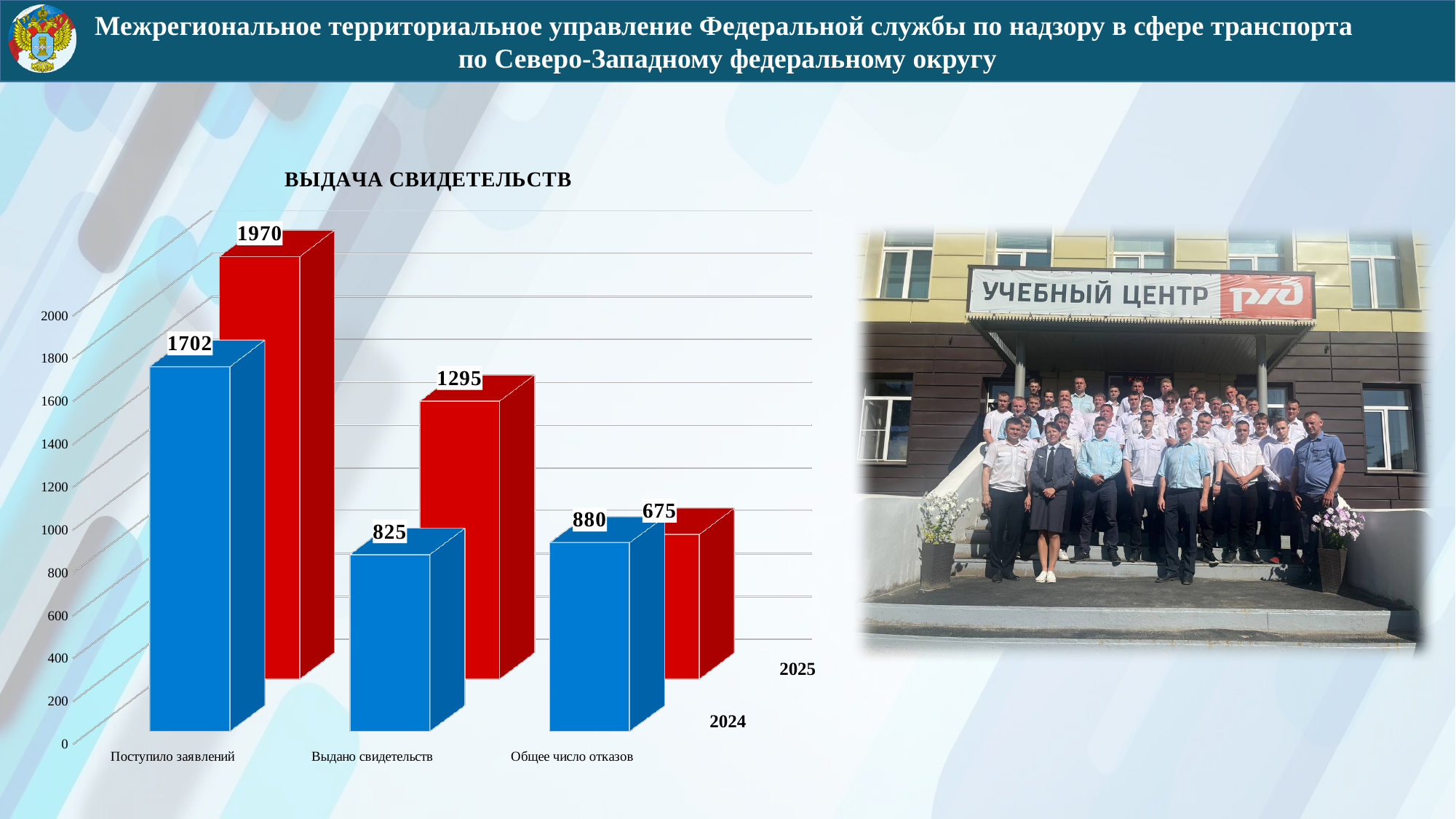
What is the value for Общее число отказов in 2024? 880 What is the title of the chart? ВЫДАЧА СВИДЕТЕЛЬСТВ Which category has the highest value in the 2025 series? Поступило заявлений What type of chart is shown on the slide? bar chart What is the value for Поступило заявлений in 2025? 1970 Which category has the lowest value in the 2024 series? Выдано свидетельств What is the value for Поступило заявлений in 2024? 1702 Which is larger for Общее число отказов: the 2024 value or the 2025 value? 2024 What is the difference between the 2025 and 2024 values for Выдано свидетельств? 470 What is the value for Выдано свидетельств in 2025? 1295 How many series does the chart show? 2 How many categories are shown on the x axis of the chart? 3